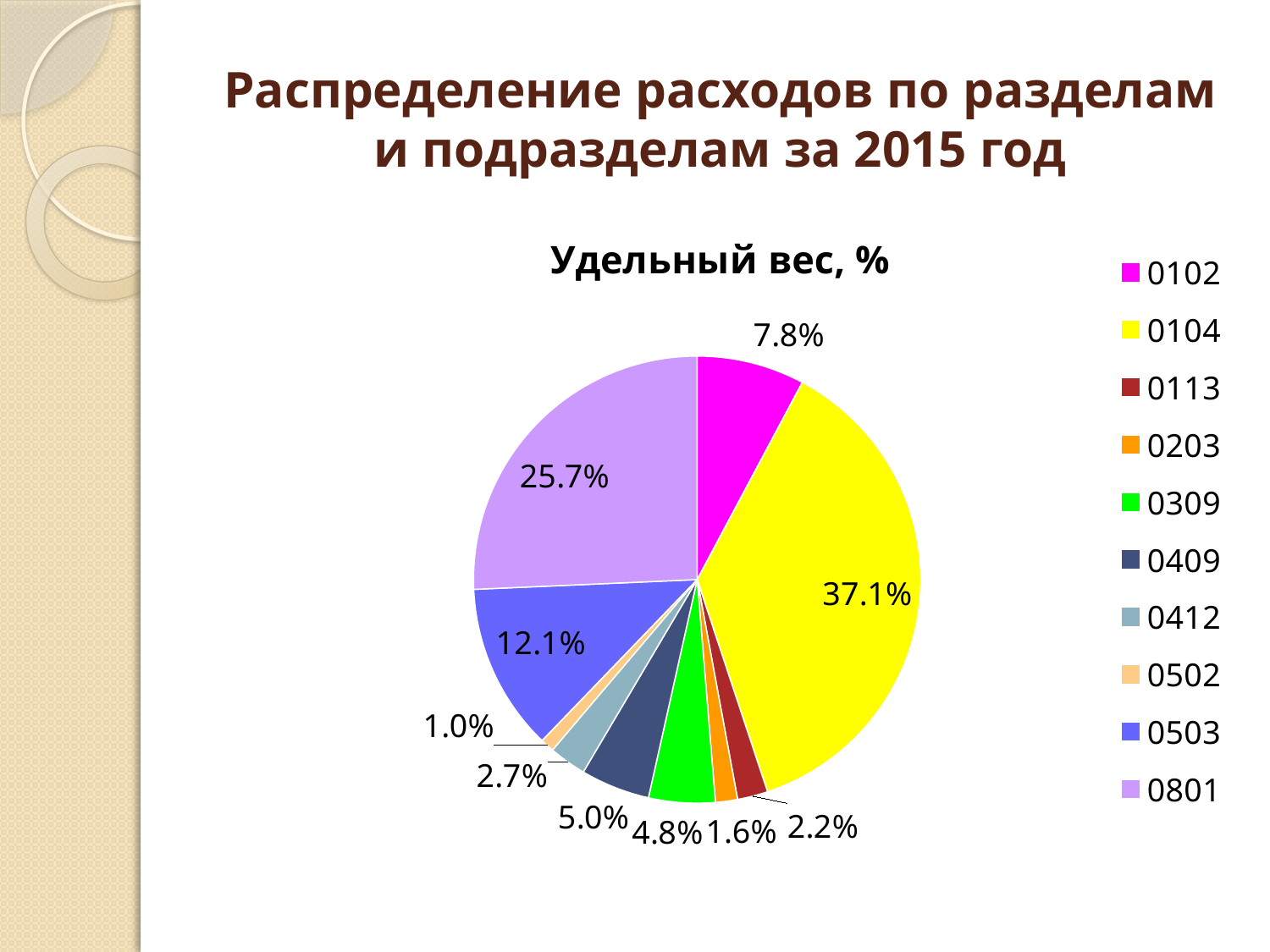
What is the title of the chart? Удельный вес, % How many categories does the legend list? 10 Which category has the largest share? 0104 Which category has the smallest share? 0502 What is the share for category 0503? 12.1% What type of chart is shown on the slide? pie chart What is the share for category 0102? 7.8% What is the share for category 0502? 1.0% What is the share for category 0104? 37.1% Which has a larger share, 0409 or 0309? 0409 What is the share for category 0801? 25.7% What is the difference between the shares of 0104 and 0801? 11.4%